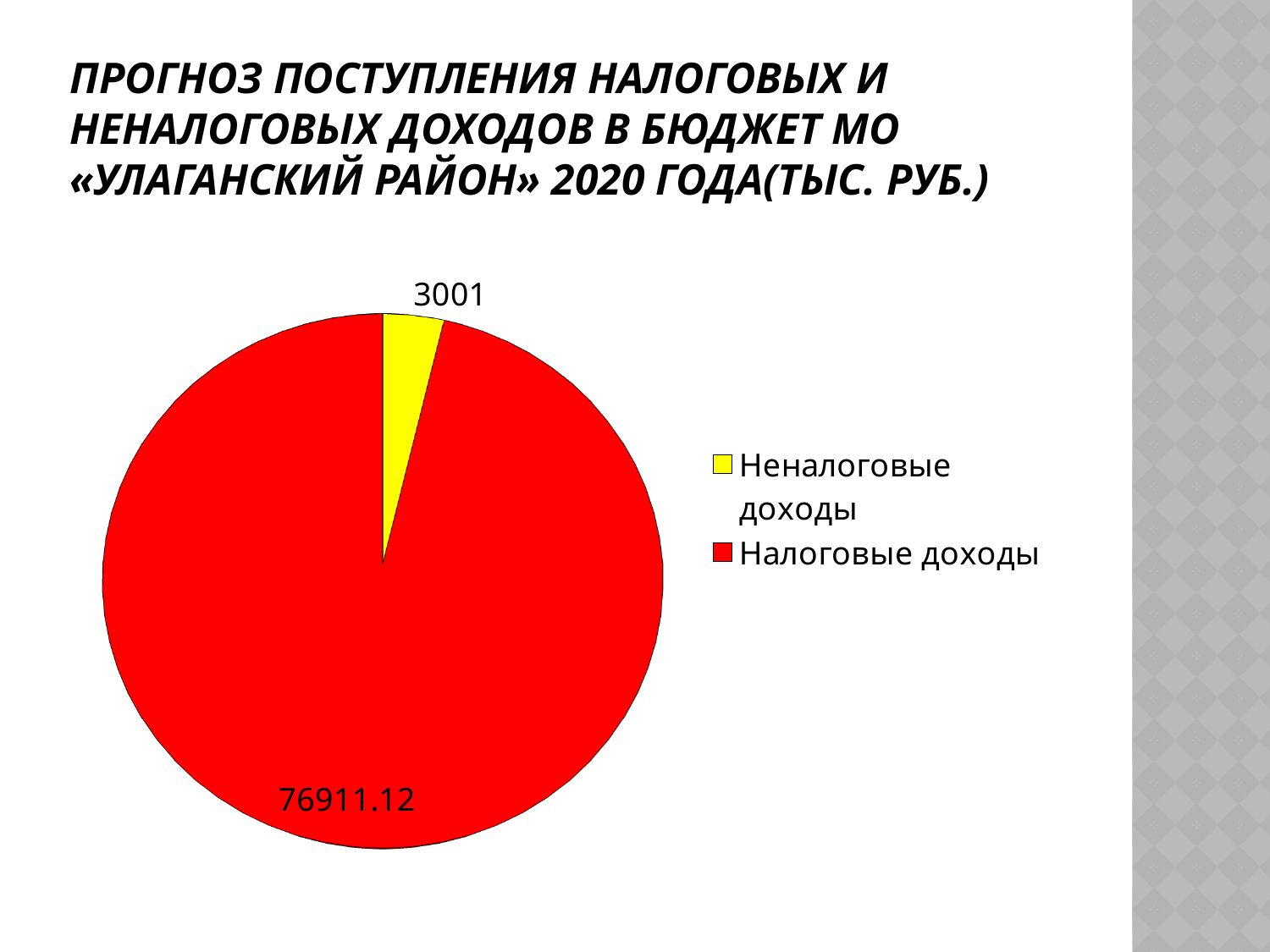
Which category has the smallest slice of the pie? Неналоговые доходы How many slices does the pie chart have? 2 What colour is the slice for Неналоговые доходы? Yellow What is the difference between the values for Налоговые доходы and Неналоговые доходы? 73910.12 Which is larger, Налоговые доходы or Неналоговые доходы? Налоговые доходы What is the total of the two values shown on the pie chart? 79912.12 How many entries does the legend list? 2 What is the value for Неналоговые доходы? 3001 Which category has the largest slice of the pie? Налоговые доходы What is the value for Налоговые доходы? 76911.12 What type of chart is shown on the slide? Pie chart